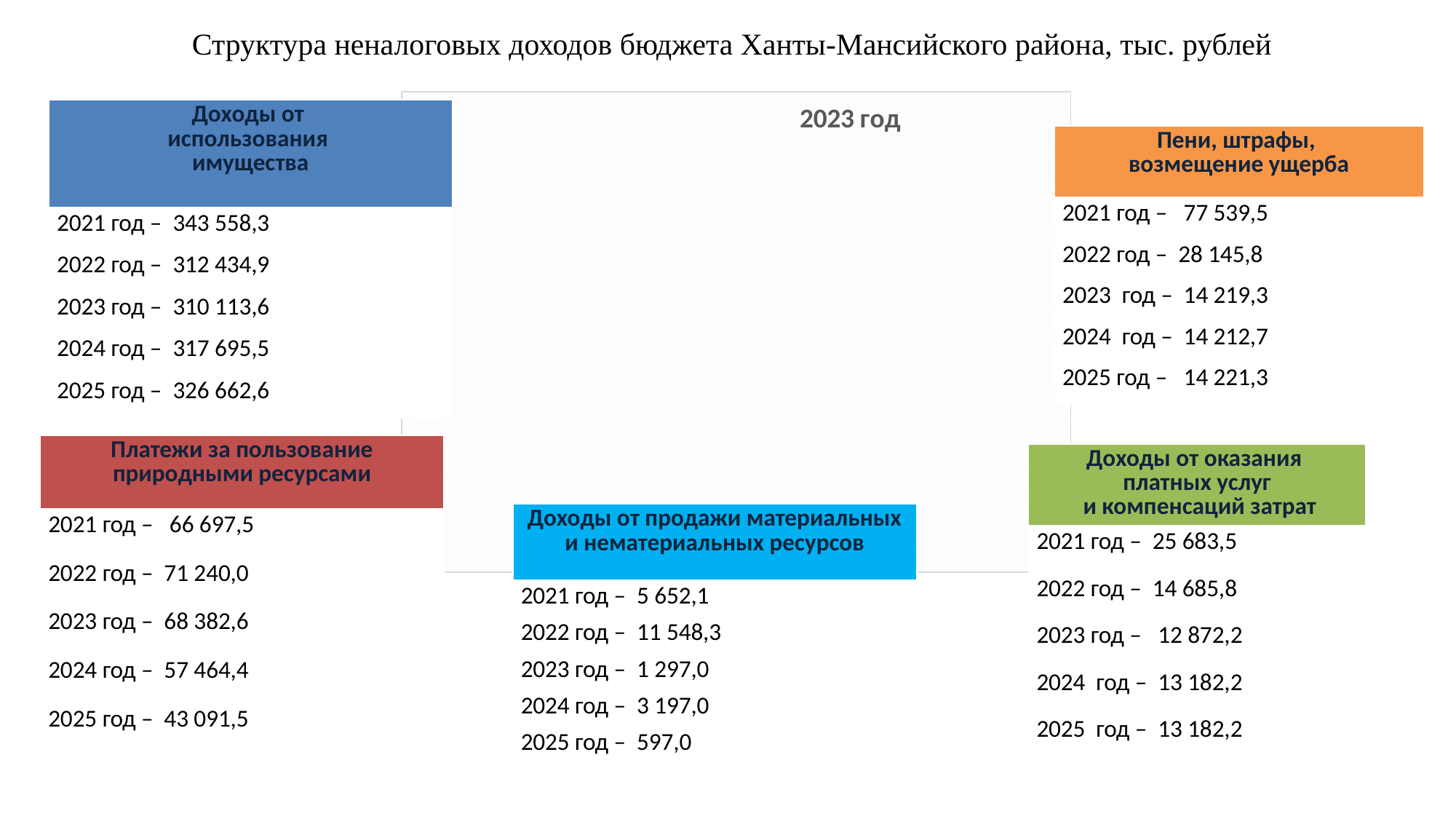
What is the value for «Доходы от использования имущества» in 2023 год? 310 113,6 What is the value for «Пени, штрафы, возмещение ущерба» in 2021 год? 77 539,5 What is the difference between the 2021 and 2022 values for «Доходы от использования имущества»? 31 123,4 In 2024 год, which is larger: «Пени, штрафы, возмещение ущерба» or «Доходы от оказания платных услуг и компенсаций затрат»? Пени, штрафы, возмещение ущерба Which category has the highest value in 2023 год? Доходы от использования имущества Do the values for «Платежи за пользование природными ресурсами» rise or fall from 2022 год to 2025 год? fall What is the difference between the 2021 and 2025 values for «Пени, штрафы, возмещение ущерба»? 63 318,2 Which category has the lowest value in 2023 год? Доходы от продажи материальных и нематериальных ресурсов What is the title shown inside the chart area? 2023 год How many categories of non-tax income are shown on the slide? 5 What is the value for «Доходы от продажи материальных и нематериальных ресурсов» in 2025 год? 597,0 What is the value for «Доходы от оказания платных услуг и компенсаций затрат» in 2022 год? 14 685,8